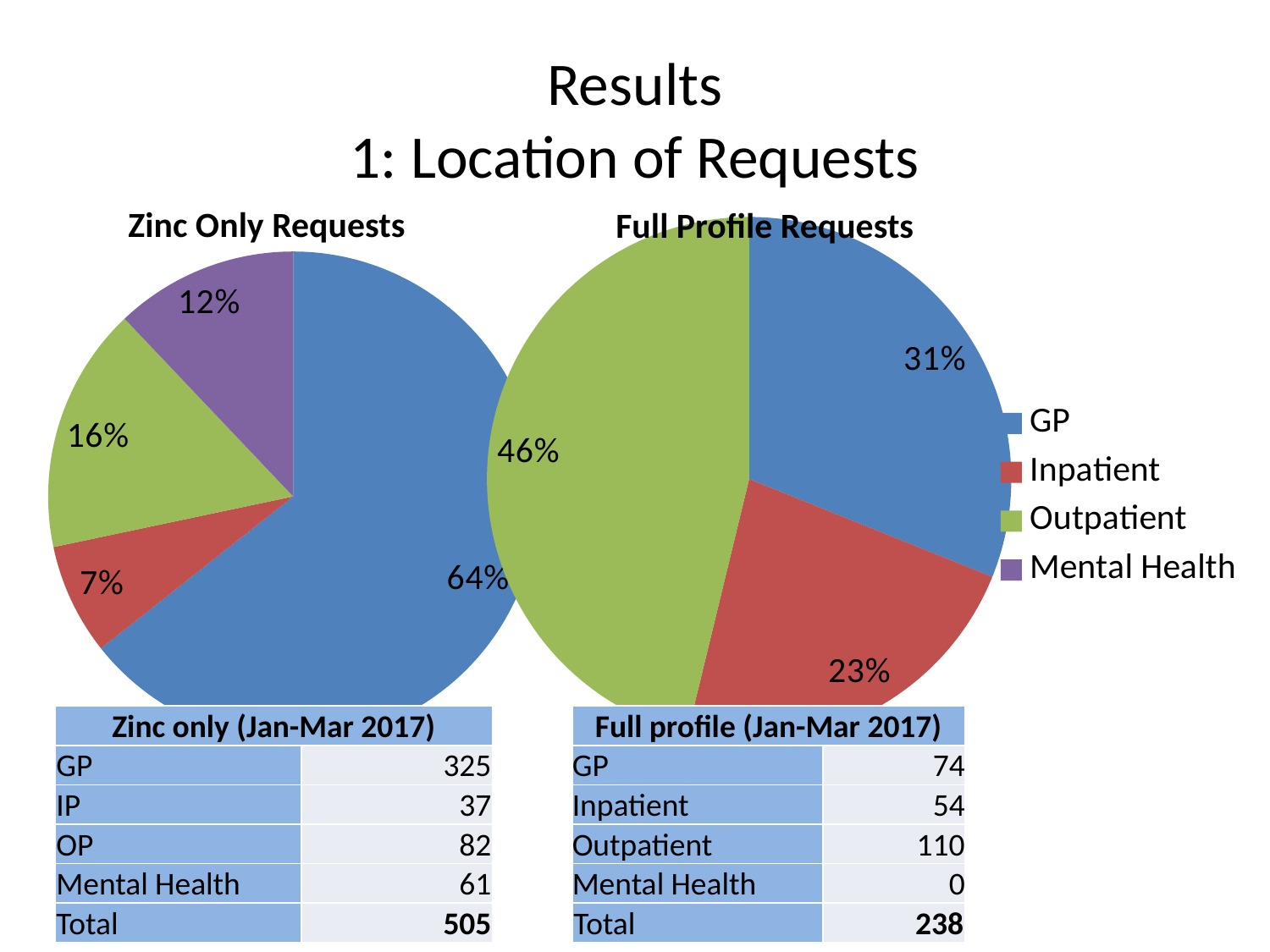
What type of chart is the "Zinc Only Requests" chart? pie chart In the "Zinc Only Requests" chart, what share of the pie is Inpatient? 7% In the "Full Profile Requests" chart, what share of the pie is Outpatient? 46% In the "Full Profile Requests" chart, which category has the largest slice? Outpatient In the "Full Profile Requests" chart, which is larger, the GP slice or the Inpatient slice? GP In the legend, which category is shown in green? Outpatient In the "Zinc Only Requests" chart, which category has the smallest slice? Inpatient In the "Zinc Only Requests" chart, what is the difference in percentage points between the GP slice and the Outpatient slice? 48 In the "Zinc Only Requests" chart, what share of the pie is Mental Health? 12% How many entries does the shared legend list? 4